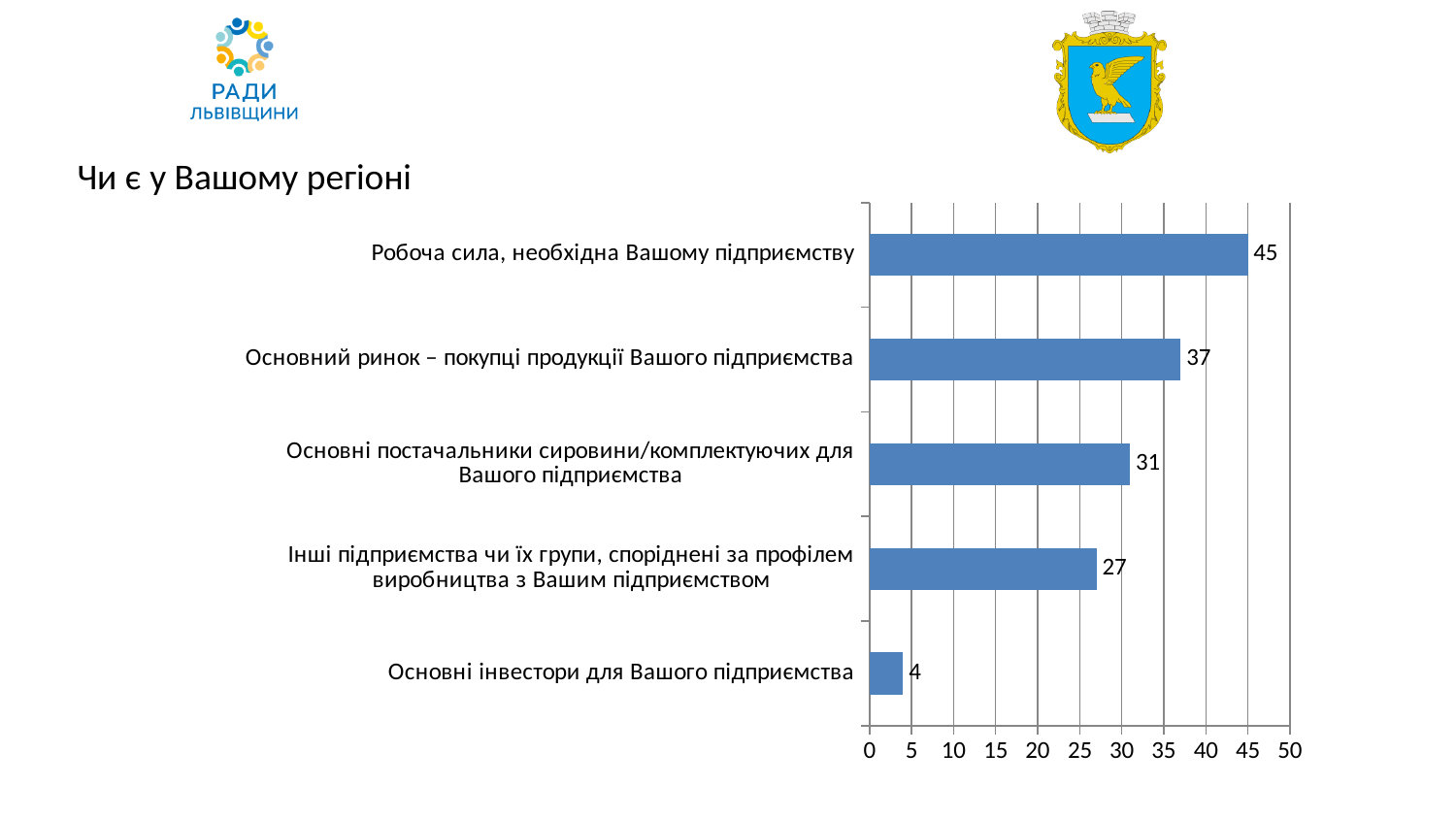
What is the value for "Основні постачальники сировини/комплектуючих для Вашого підприємства"? 31 How many categories are shown in the chart? 5 Which category has the highest value? Робоча сила, необхідна Вашому підприємству What is the maximum value shown on the horizontal axis? 50 Which is larger: the value for "Основний ринок – покупці продукції Вашого підприємства" or for "Основні постачальники сировини/комплектуючих для Вашого підприємства"? Основний ринок – покупці продукції Вашого підприємства What is the difference between the values for "Основний ринок – покупці продукції Вашого підприємства" and "Інші підприємства чи їх групи, споріднені за профілем виробництва з Вашим підприємством"? 10 Which category has the lowest value? Основні інвестори для Вашого підприємства Is the value for "Інші підприємства чи їх групи, споріднені за профілем виробництва з Вашим підприємством" greater or less than 30? less What kind of chart is shown on the slide? bar chart What is the value for "Основні інвестори для Вашого підприємства"? 4 What is the title of the slide above the chart? Чи є у Вашому регіоні What is the value for "Робоча сила, необхідна Вашому підприємству"? 45